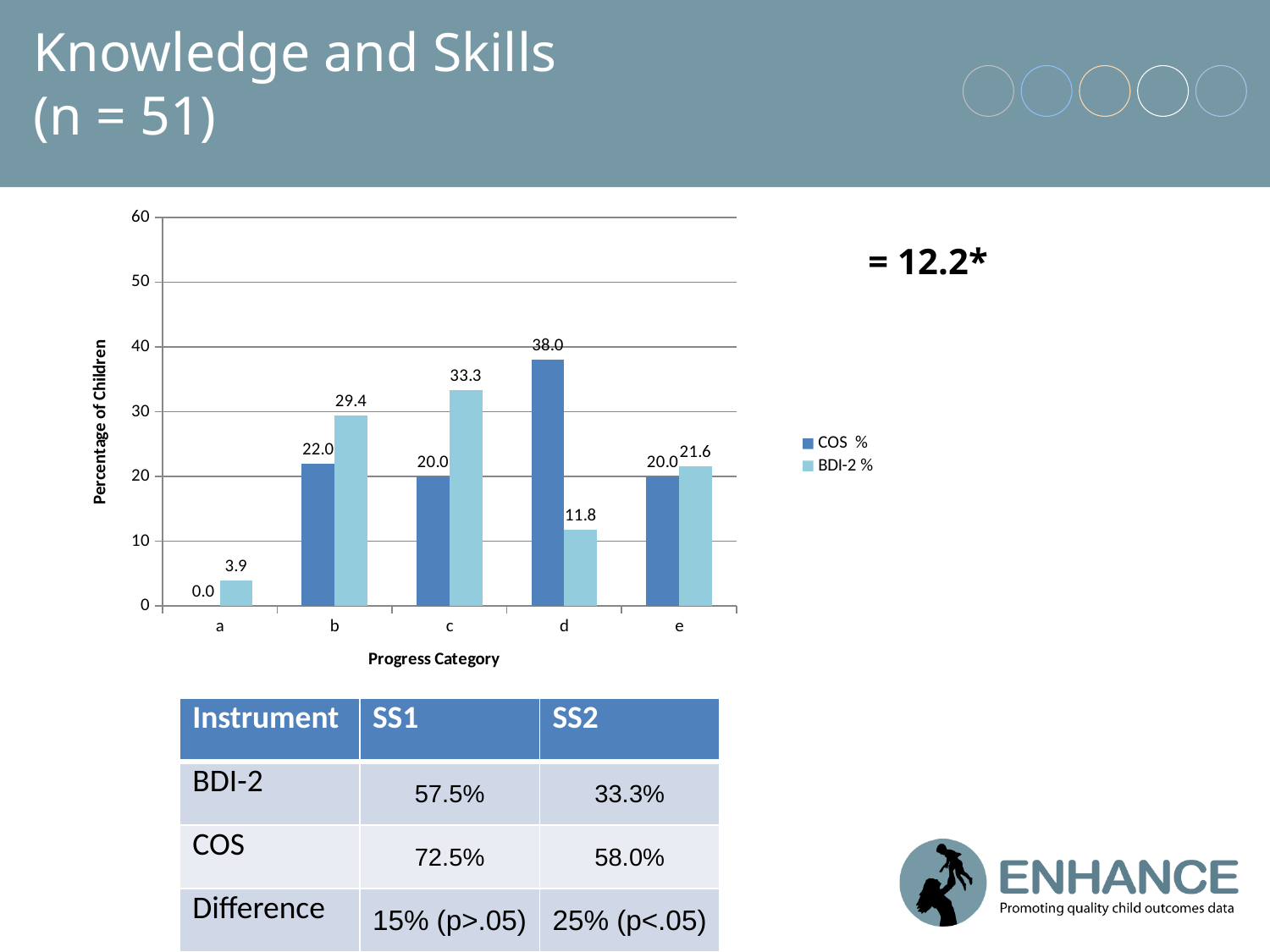
How many series does the legend list? 2 Which progress category has the lowest BDI-2 % value? a Which progress category has the highest COS % value? d What is the BDI-2 % value for progress category a? 3.9 Is the BDI-2 % value for progress category c greater or less than 30? greater What is the BDI-2 % value for progress category c? 33.3 What is the difference between the COS % and BDI-2 % values for progress category d? 26.2 What is the label of the y axis of the chart? Percentage of Children What kind of chart is shown on the slide? bar chart How many progress categories are shown on the x axis? 5 What is the COS % value for progress category d? 38.0 For progress category b, which series has the larger value, COS % or BDI-2 %? BDI-2 %